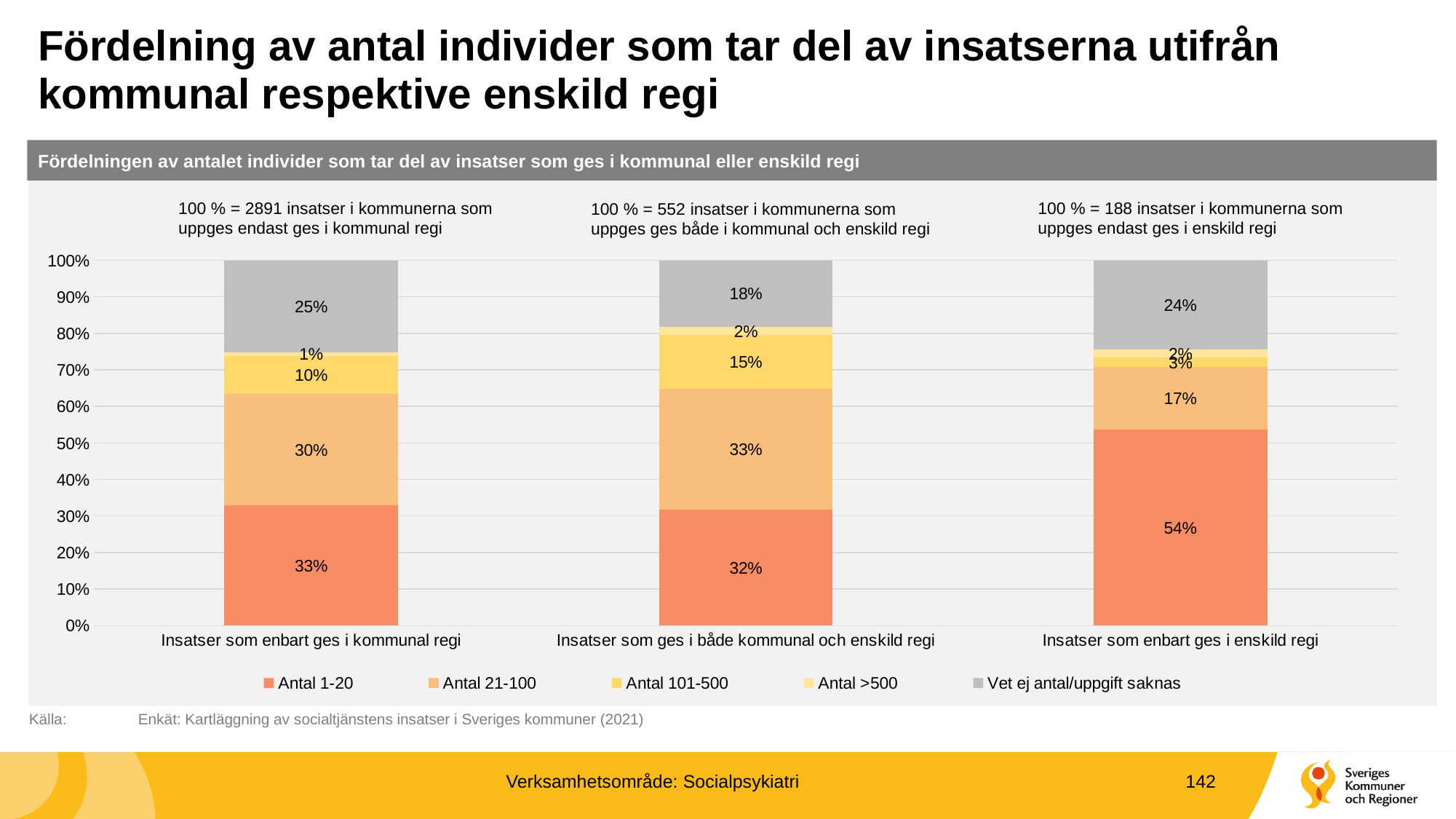
Which category has the lowest value for 'Vet ej antal/uppgift saknas'? Insatser som ges i både kommunal och enskild regi What is the difference between the 'Antal 1-20' value for 'Insatser som enbart ges i enskild regi' and for 'Insatser som enbart ges i kommunal regi'? 21 percentage points What is the value for 'Antal 21-100' in the category 'Insatser som ges i både kommunal och enskild regi'? 33% According to the note above the first bar, how many insatser does 100 % correspond to for 'Insatser som enbart ges i kommunal regi'? 2891 Which category has the highest value for 'Antal 1-20'? Insatser som enbart ges i enskild regi What kind of chart is shown on the slide? Stacked bar chart Which is larger: the 'Antal 21-100' value for 'Insatser som enbart ges i kommunal regi' or for 'Insatser som enbart ges i enskild regi'? Insatser som enbart ges i kommunal regi What is the value for 'Vet ej antal/uppgift saknas' in the category 'Insatser som enbart ges i kommunal regi'? 25% What is the value for 'Antal 1-20' in the category 'Insatser som enbart ges i enskild regi'? 54% How many series does the legend list? 5 How many categories are shown on the x axis of the chart? 3 What is the value for 'Antal 101-500' in the category 'Insatser som ges i både kommunal och enskild regi'? 15%